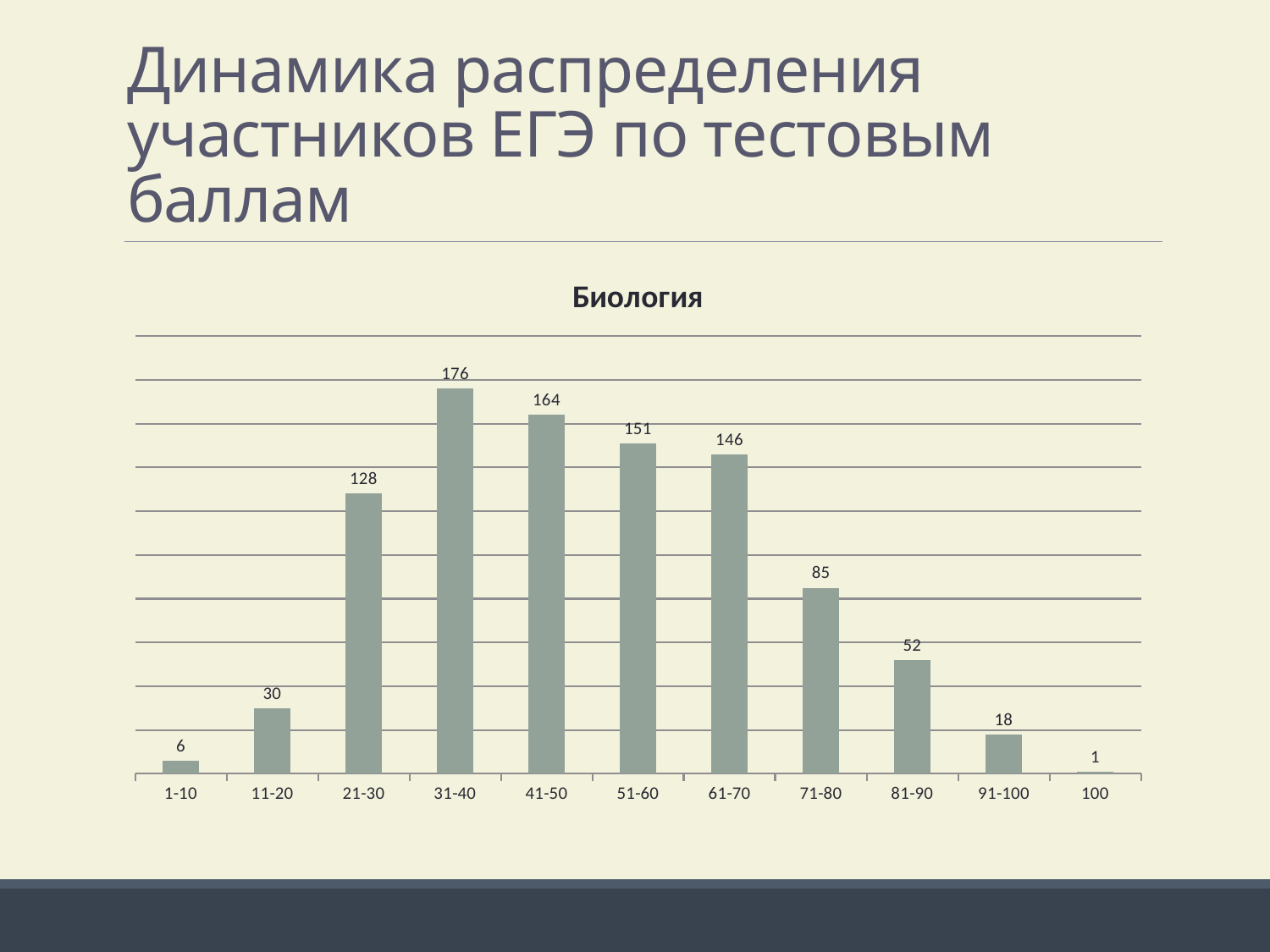
Which score range has the highest number of participants? 31-40 What is the difference between the values for 41-50 and 51-60? 13 What is the value for the 91-100 score range? 18 How many score ranges are shown on the x axis? 11 What is the title of the chart? Биология Do the values rise or fall from 31-40 to 100 along the x axis? fall Which is larger, the value for 61-70 or the value for 71-80? 61-70 Which score range has the lowest number of participants? 100 What kind of chart is shown on the slide? bar chart What is the value for the 71-80 score range? 85 What is the difference between the values for 21-30 and 11-20? 98 What is the value for the 31-40 score range? 176